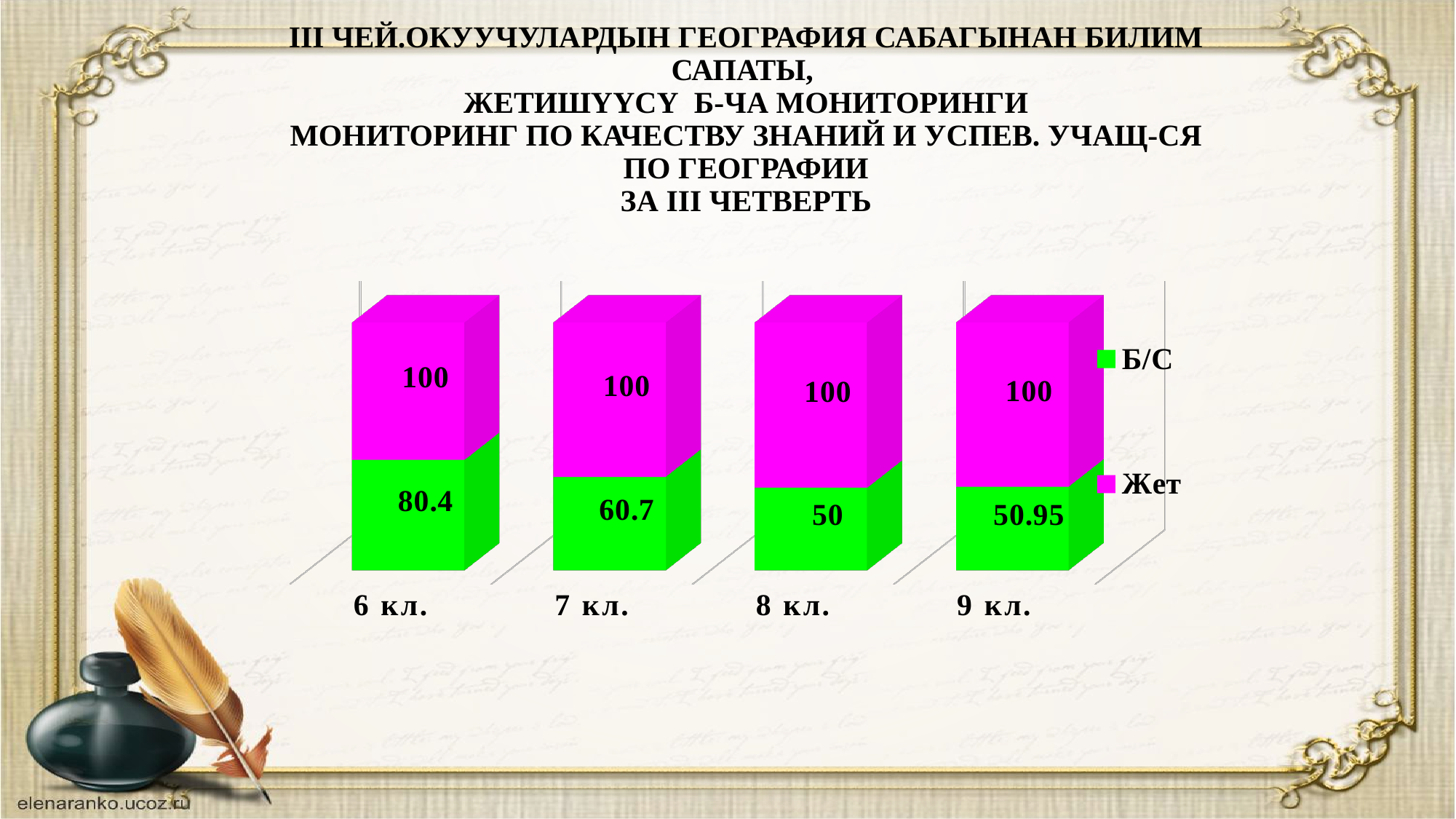
Which colour represents the Жет series in the legend? Magenta What is the difference between the Б/С values for 6 кл. and 7 кл.? 19.7 How many series does the legend list? 2 What is the Б/С value for 9 кл.? 50.95 What is the Б/С value for 6 кл.? 80.4 Which class has the lowest Б/С value? 8 кл. Which is larger, the Б/С value for 7 кл. or for 9 кл.? 7 кл. What is the Б/С value for 7 кл.? 60.7 What is the Жет value for 8 кл.? 100 Which class has the highest Б/С value? 6 кл. How many classes are shown on the x axis? 4 What kind of chart is shown on the slide? Stacked bar chart